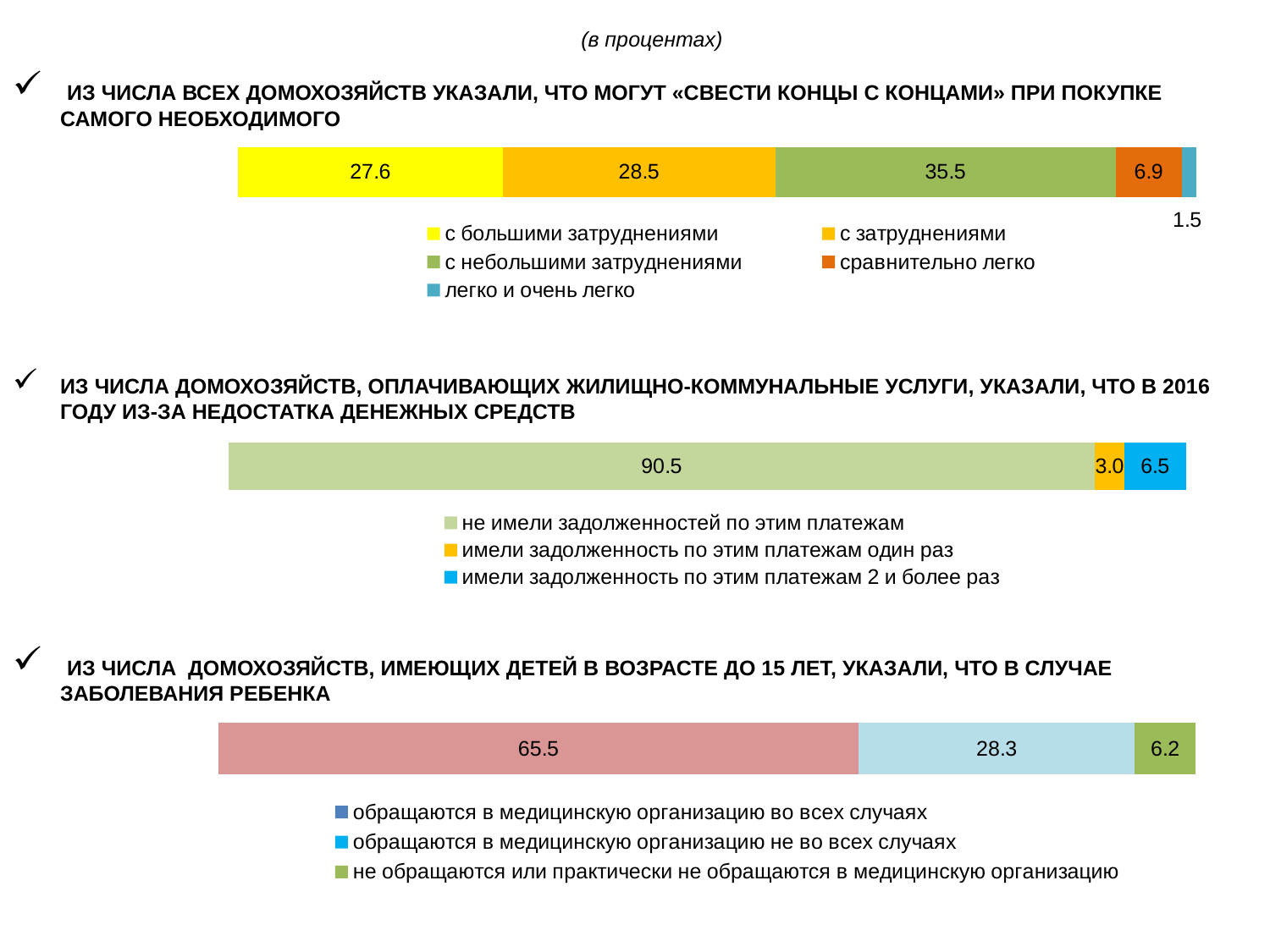
In the top chart, which category has the lowest value? легко и очень легко In the middle chart, what is the value for «не имели задолженностей по этим платежам»? 90.5 How many entries does the legend of the top chart list? 5 In the bottom chart, what is the value for «не обращаются или практически не обращаются в медицинскую организацию»? 6.2 What kind of chart is the bottom chart? stacked bar chart In the top chart, what is the value for «с небольшими затруднениями»? 35.5 In the top chart, which category has the highest value? с небольшими затруднениями In the middle chart, what is the difference between the values for «имели задолженность по этим платежам 2 и более раз» and «имели задолженность по этим платежам один раз»? 3.5 In the top chart, what is the difference between the values for «с затруднениями» and «с большими затруднениями»? 0.9 In the middle chart, which is larger: «имели задолженность по этим платежам один раз» or «имели задолженность по этим платежам 2 и более раз»? имели задолженность по этим платежам 2 и более раз What is the total of the segments in the bottom chart? 100.0 In the top chart, what is the value for «сравнительно легко»? 6.9